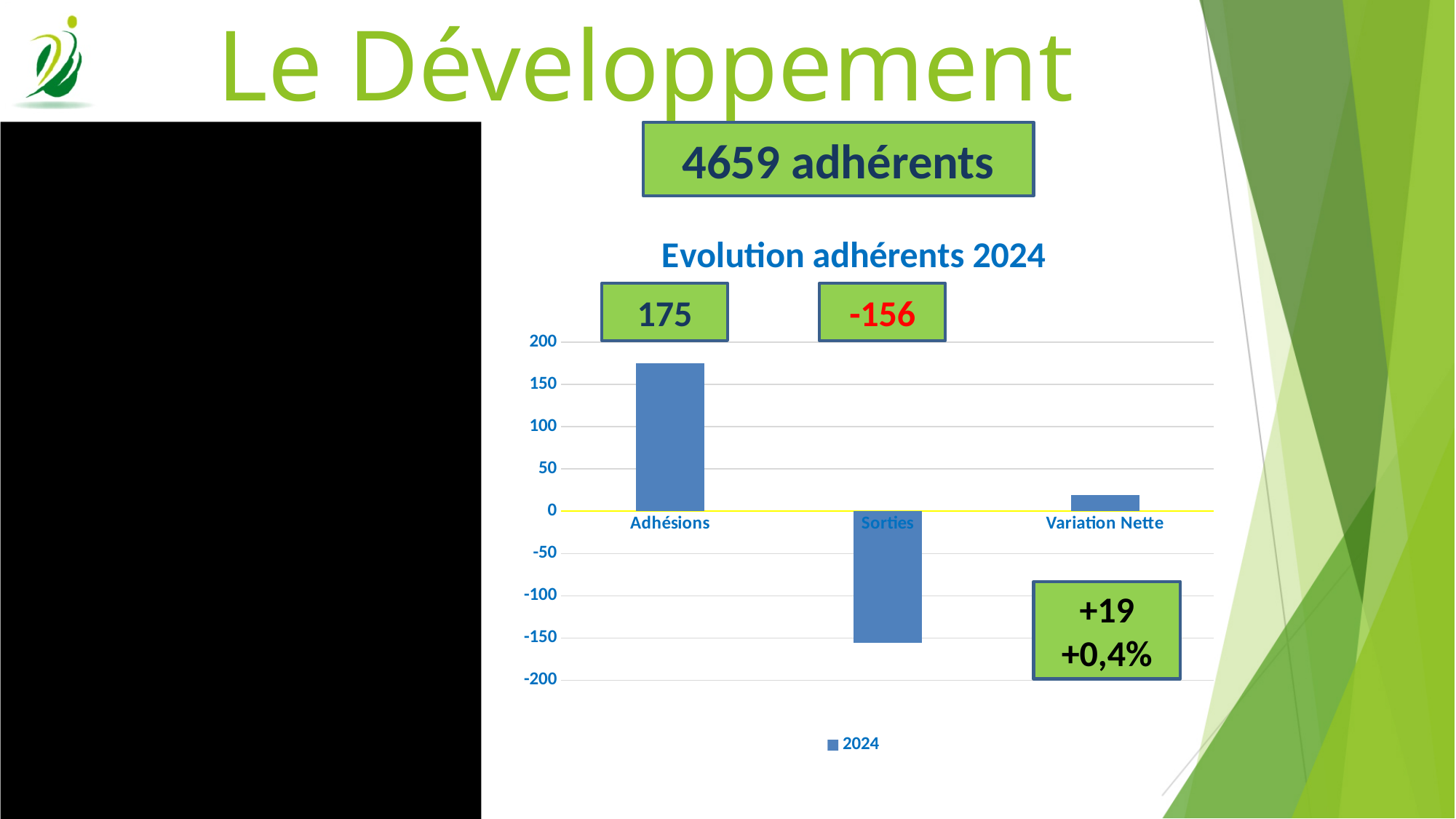
What series name appears in the legend? 2024 What is the value shown for Sorties? -156 What is the value shown for Adhésions? 175 Which is larger, the value for Adhésions or the value for Variation Nette? Adhésions How many series does the legend list? 1 Which category has the highest value? Adhésions Which category has the lowest value? Sorties How many categories are plotted on the x axis? 3 Is the value for Adhésions greater or less than 150? greater What kind of chart is shown on the slide? bar chart What is the value shown for Variation Nette? +19 What is the title of the chart? Evolution adhérents 2024